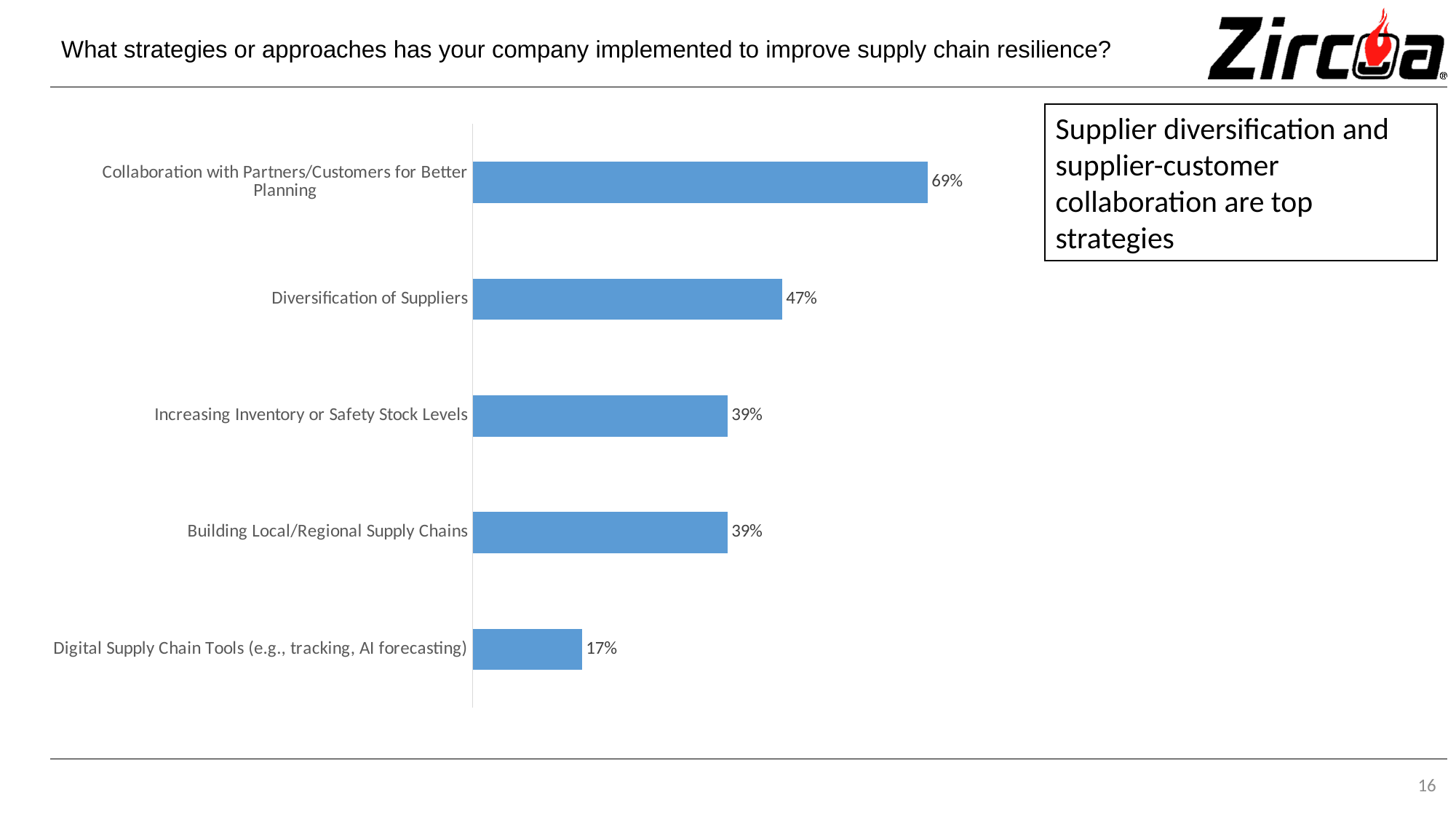
Which strategy has the lowest value? Digital Supply Chain Tools (e.g., tracking, AI forecasting) What question does the chart on the slide address? What strategies or approaches has your company implemented to improve supply chain resilience? How many strategies are shown in the chart? 5 What is the value for Diversification of Suppliers? 47% What is the difference between the values for Increasing Inventory or Safety Stock Levels and Digital Supply Chain Tools (e.g., tracking, AI forecasting)? 22% Which is larger: the value for Diversification of Suppliers or the value for Building Local/Regional Supply Chains? Diversification of Suppliers What kind of chart is shown on the slide? Bar chart What percentage of companies implemented Collaboration with Partners/Customers for Better Planning? 69% What is the value for Digital Supply Chain Tools (e.g., tracking, AI forecasting)? 17% What is the value for Building Local/Regional Supply Chains? 39% Which strategy has the highest value? Collaboration with Partners/Customers for Better Planning What is the difference between the values for Collaboration with Partners/Customers for Better Planning and Diversification of Suppliers? 22%